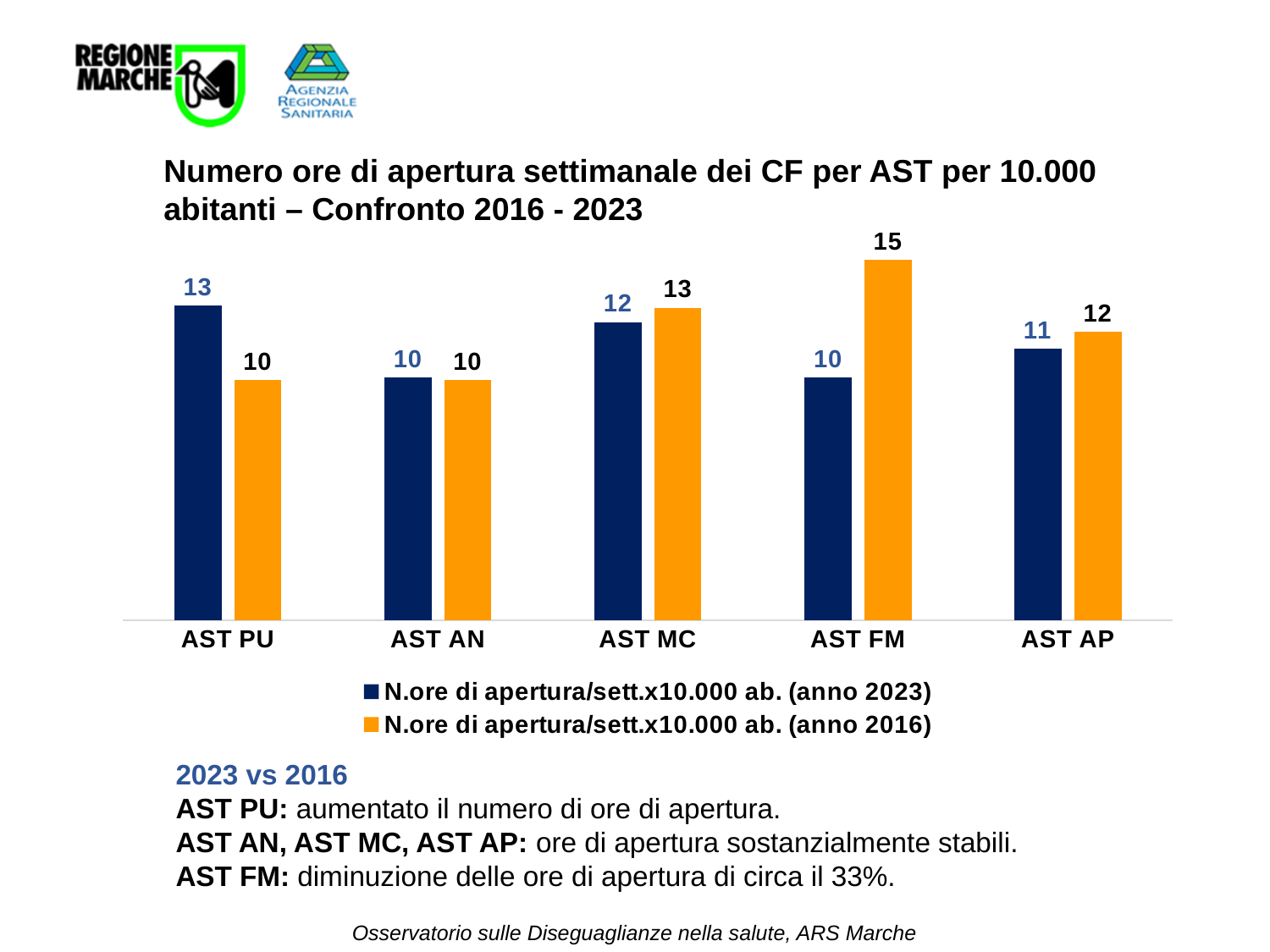
Which AST has the highest value in the 2023 series? AST PU How many AST categories are shown on the x axis? 5 What is the difference between the 2023 and 2016 values for AST PU? 3 What is the value for AST FM in the 2016 series (N.ore di apertura/sett.x10.000 ab. (anno 2016))? 15 Which AST has the highest value in the 2016 series? AST FM What kind of chart is shown on the slide? Bar chart Which AST has the lowest value in the 2016 series? AST PU and AST AN (both 10) What is the value for AST AP in the 2023 series? 11 How many series does the legend list? 2 What is the difference between the 2016 and 2023 values for AST FM? 5 For AST MC, which is larger: the 2023 value or the 2016 value? The 2016 value (13) What is the value for AST PU in the 2023 series (N.ore di apertura/sett.x10.000 ab. (anno 2023))? 13